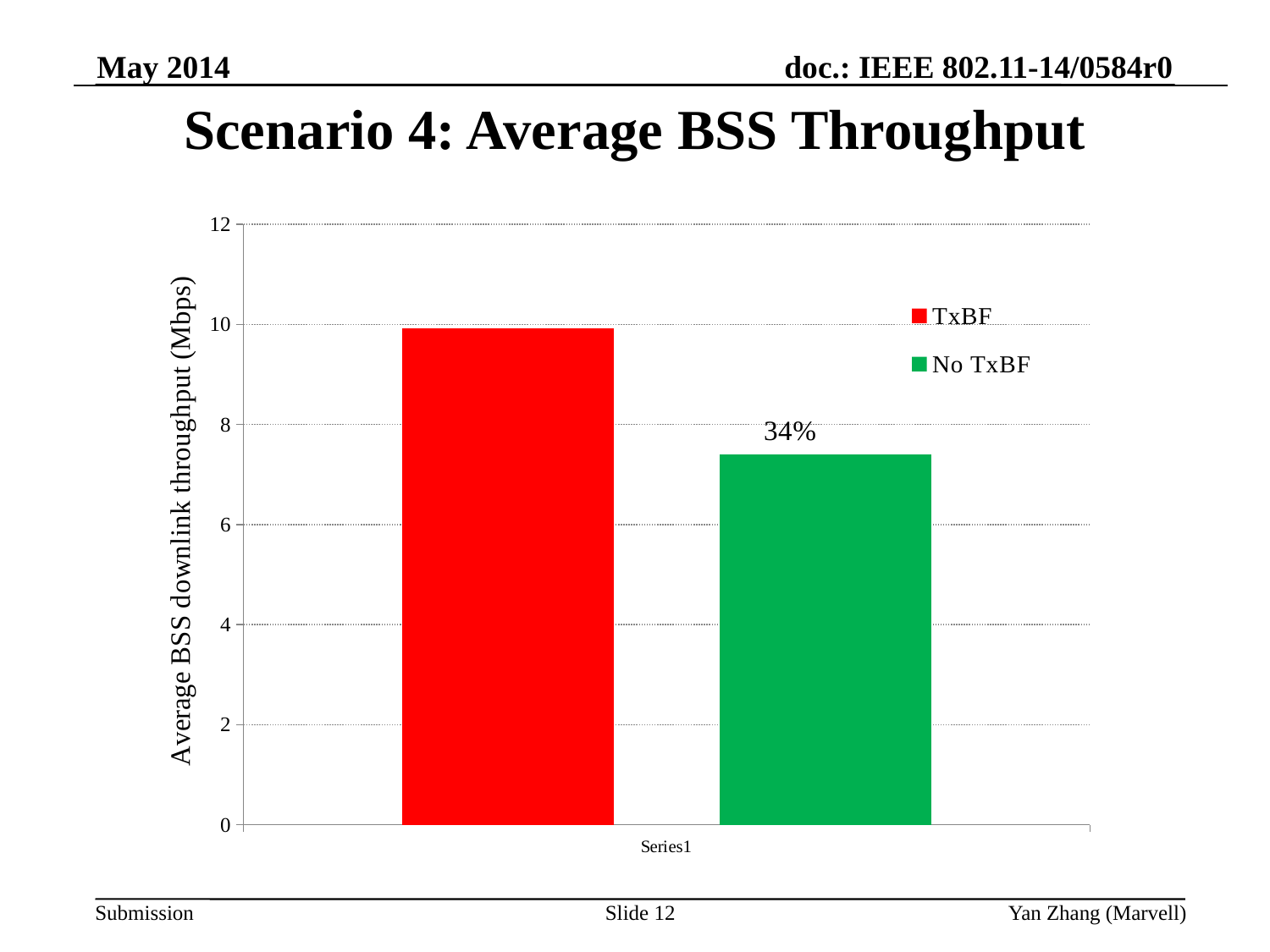
What is the title of the chart on the slide? Scenario 4: Average BSS Throughput How many series does the legend list? 2 Is the value for TxBF greater or less than 8? greater What is the label of the y axis? Average BSS downlink throughput (Mbps) Which series has the lowest bar in the chart? No TxBF Is the value for No TxBF greater or less than 8? less Which series has the highest bar in the chart? TxBF What colour is the bar for No TxBF? green Which series has the higher average BSS downlink throughput, TxBF or No TxBF? TxBF Is the value for No TxBF greater or less than 6? greater What kind of chart is shown on the slide? bar chart